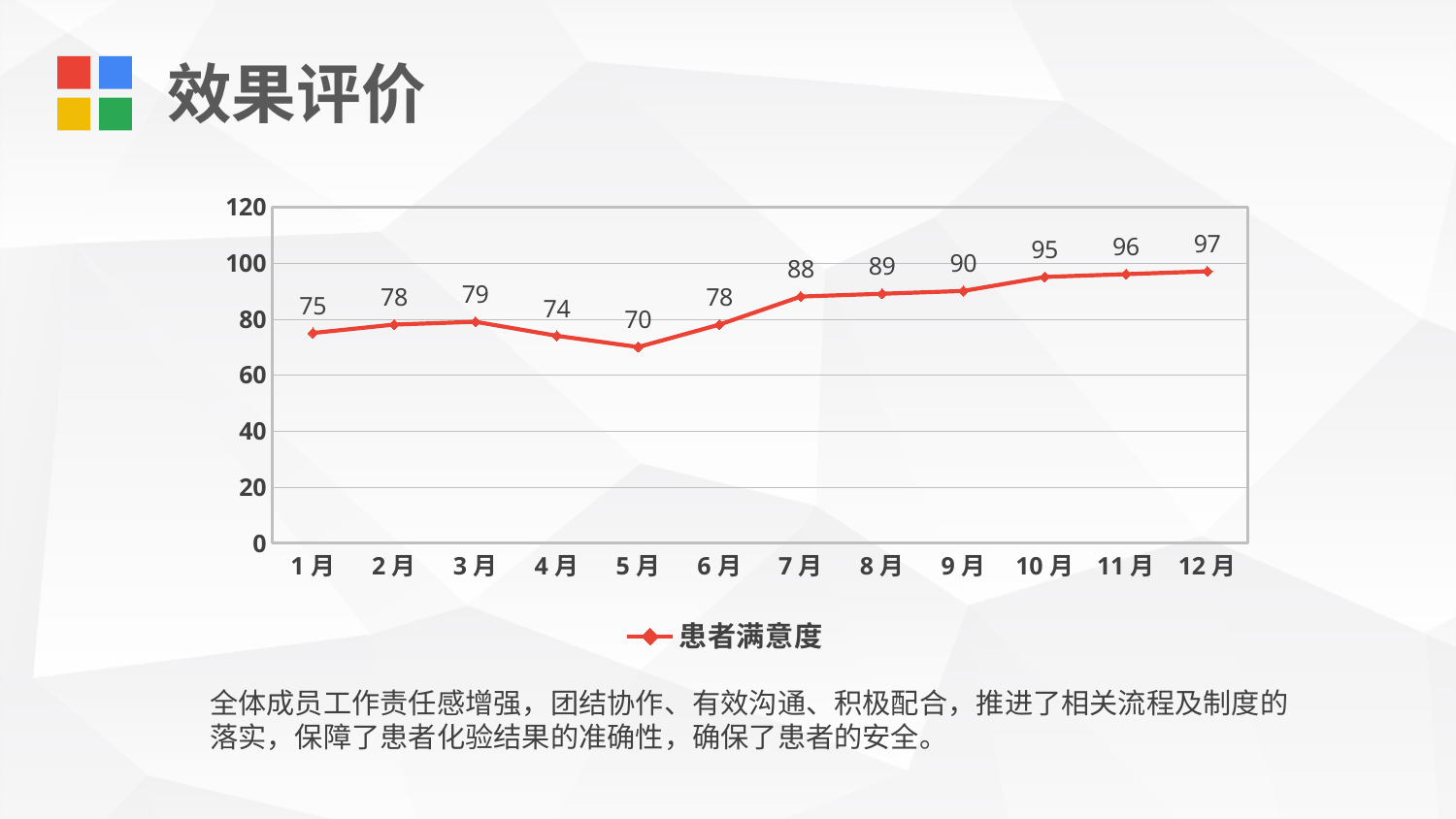
Which month has the highest 患者满意度? 12月 What kind of chart is shown on the slide? line chart What is the difference between the 患者满意度 values for 12月 and 5月? 27 How many months are plotted on the x axis? 12 How many series does the legend list? 1 Is the 患者满意度 value for 10月 greater or less than 80? greater What is the name of the series shown in the legend? 患者满意度 What is the 患者满意度 value for 7月? 88 What is the 患者满意度 value for 12月? 97 Which month has a higher 患者满意度, 3月 or 4月? 3月 Which month has the lowest 患者满意度? 5月 What is the 患者满意度 value for 5月? 70